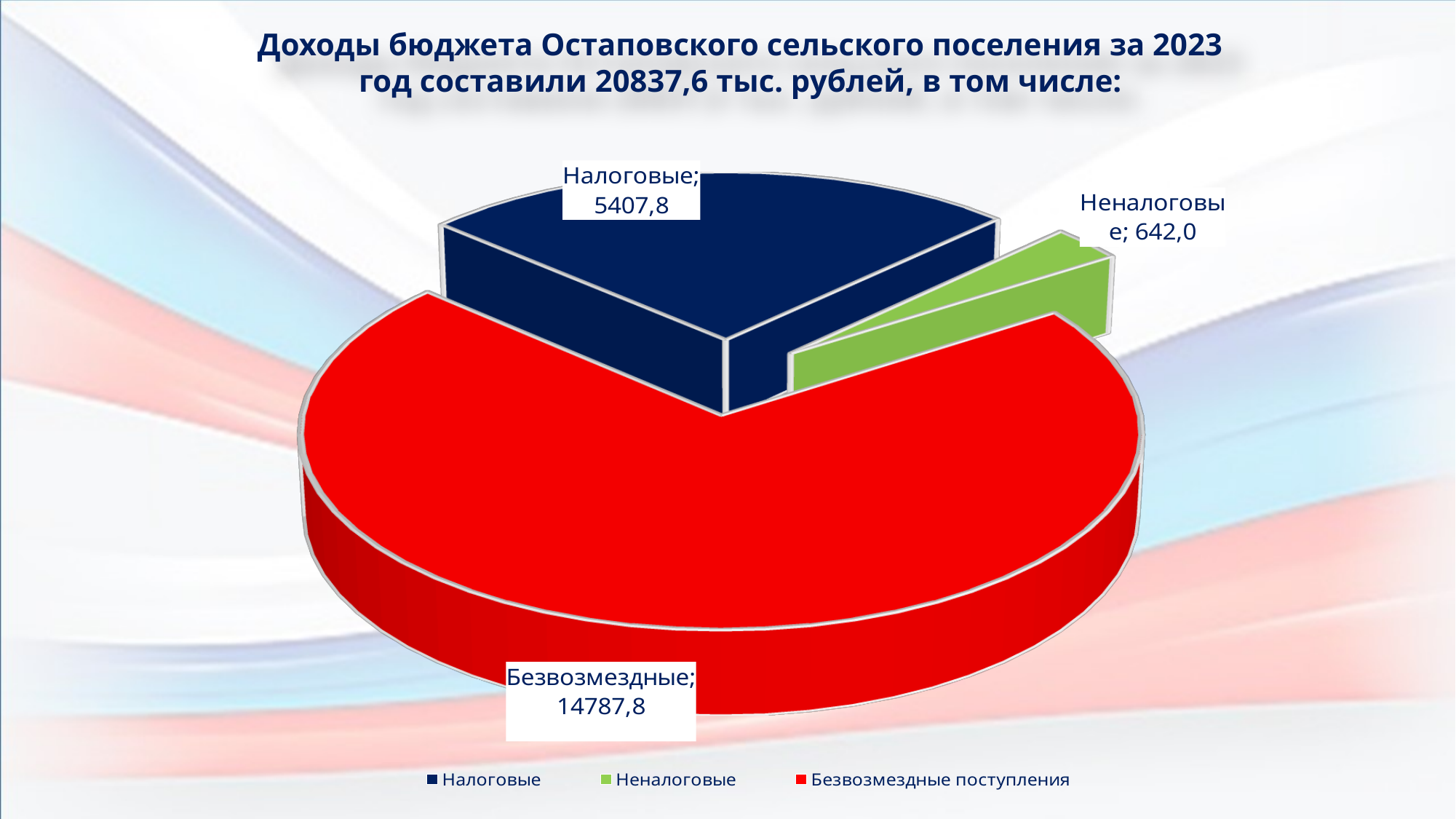
How many entries does the legend list? 3 Which is larger, the value for Налоговые or the value for Неналоговые? Налоговые Which category has the largest slice of the pie? Безвозмездные What is the value for Налоговые? 5407,8 What is the difference between the values for Налоговые and Неналоговые? 4765,8 What is the difference between the values for Безвозмездные and Налоговые? 9380,0 What is the value for Неналоговые? 642,0 What is the value for Безвозмездные? 14787,8 What colour is the slice for Безвозмездные поступления? Red What type of chart is shown on the slide? Pie chart Which category has the smallest slice of the pie? Неналоговые How many slices does the pie chart have? 3